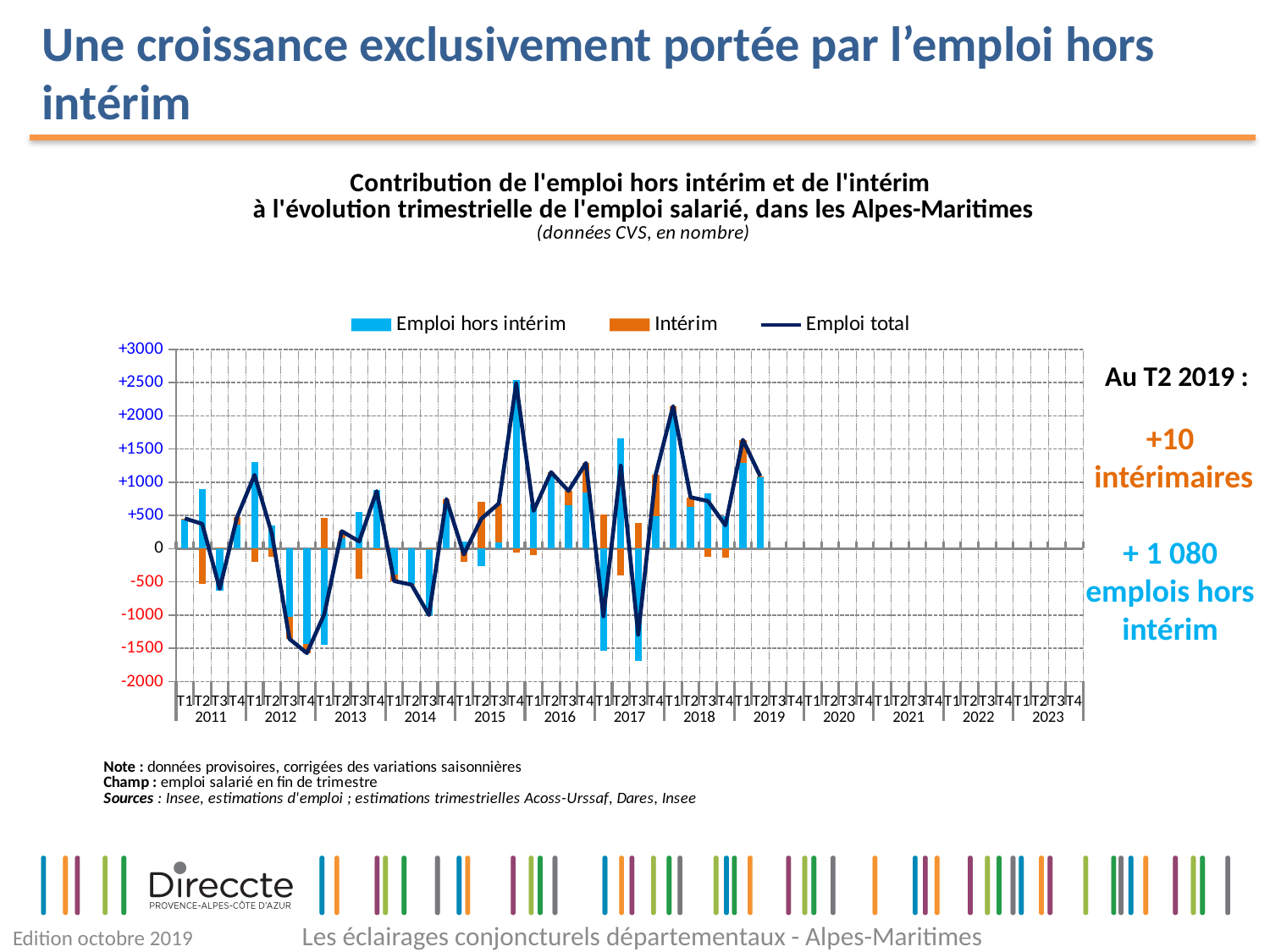
According to the slide, what is the value for Emploi hors intérim at T2 2019? + 1 080 According to the slide, what is the value for Intérim at T2 2019? +10 Is the value of Emploi hors intérim at T3 2017 greater or less than -1000? less Which is larger, the Emploi hors intérim bar at T1 2016 or at T1 2018? T1 2018 How many years are labelled on the x axis? 13 What kind of chart is shown on the slide? A combined bar and line chart (stacked bars with a line) How many series does the legend list? 3 Does the Emploi total line rise or fall from T1 2018 to T3 2018? fall Is the value of Emploi total at T1 2016 greater or less than +2000? less In which quarter does the Emploi total line reach its highest value? T4 2015 What is the highest value shown on the vertical axis? +3000 In which quarter does the Emploi total line reach its lowest value? T4 2012